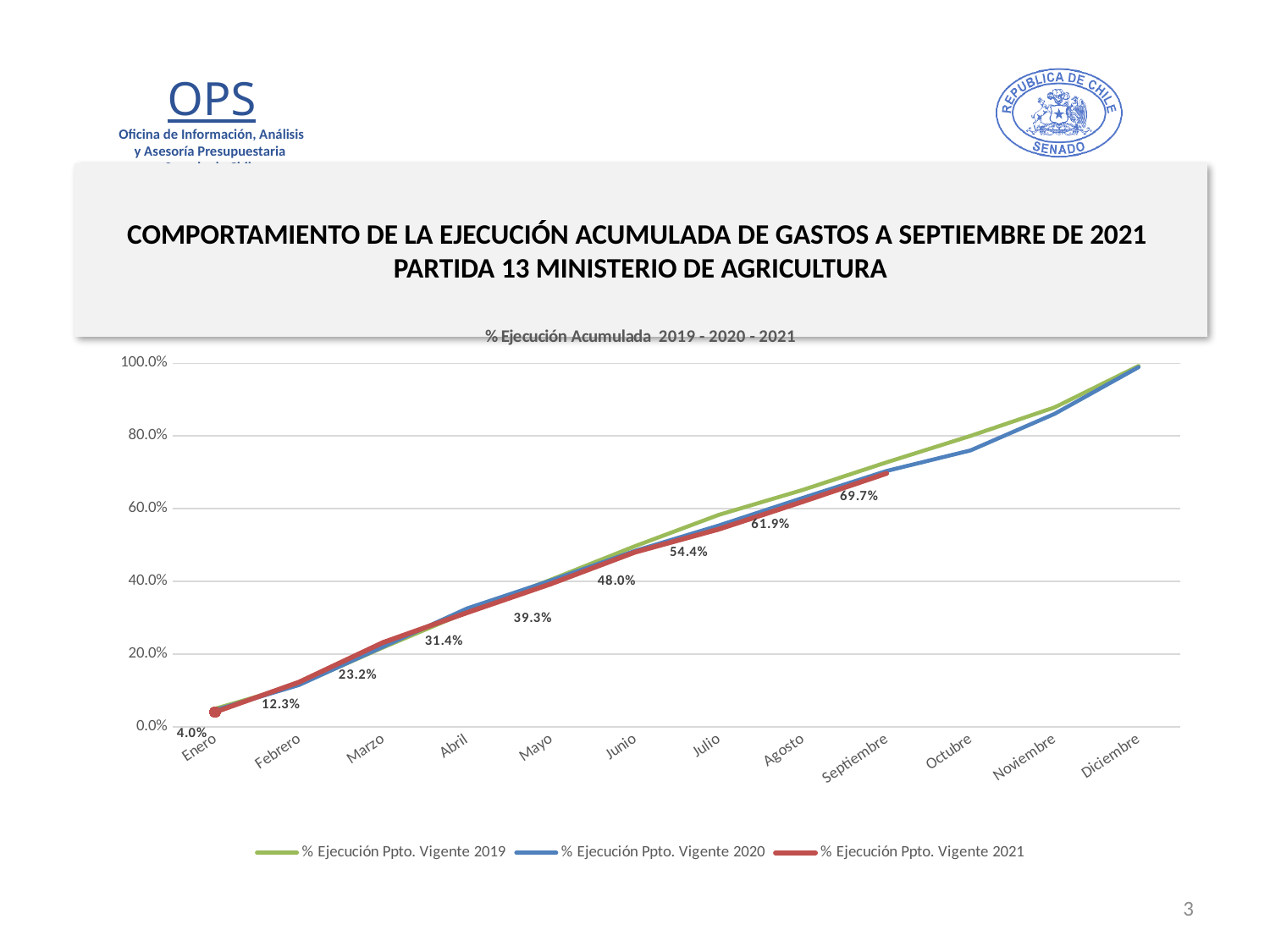
Which month has the lowest value in the % Ejecución Ppto. Vigente 2021 series? Enero What kind of chart is shown on the slide? Line chart Is the value for Diciembre in the % Ejecución Ppto. Vigente 2019 series greater or less than 80.0%? greater What is the value for Septiembre in the % Ejecución Ppto. Vigente 2021 series? 69.7% What is the difference between the Agosto and Julio values in the % Ejecución Ppto. Vigente 2021 series? 7.5% What is the value for Enero in the % Ejecución Ppto. Vigente 2021 series? 4.0% What is the value for Mayo in the % Ejecución Ppto. Vigente 2021 series? 39.3% Which month has the highest value in the % Ejecución Ppto. Vigente 2021 series? Septiembre What is the difference between the Septiembre and Enero values in the % Ejecución Ppto. Vigente 2021 series? 65.7% How many series does the legend list? 3 What is the value for Julio in the % Ejecución Ppto. Vigente 2021 series? 54.4% How many months are shown on the x axis? 12